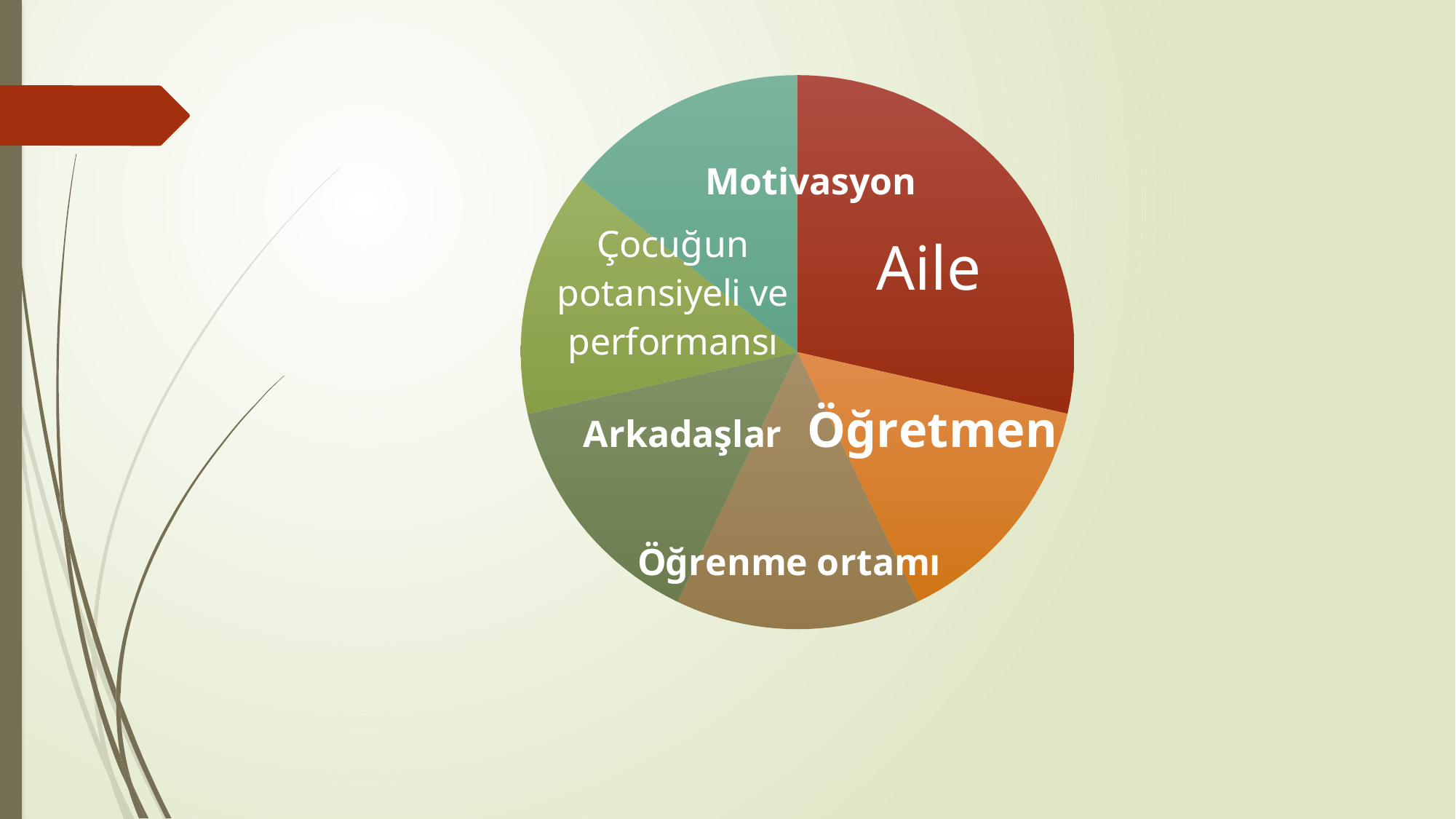
What kind of chart is shown on the slide? pie chart Which slice of the pie chart is coloured orange? Öğretmen How many slices does the pie chart have? 6 Which slice of the pie chart is the largest? Aile Which is larger in the pie chart, the Aile slice or the Arkadaşlar slice? Aile Which is larger in the pie chart, the Aile slice or the Motivasyon slice? Aile Which is larger in the pie chart, the Aile slice or the Öğrenme ortamı slice? Aile What colour is the Aile slice in the pie chart? red